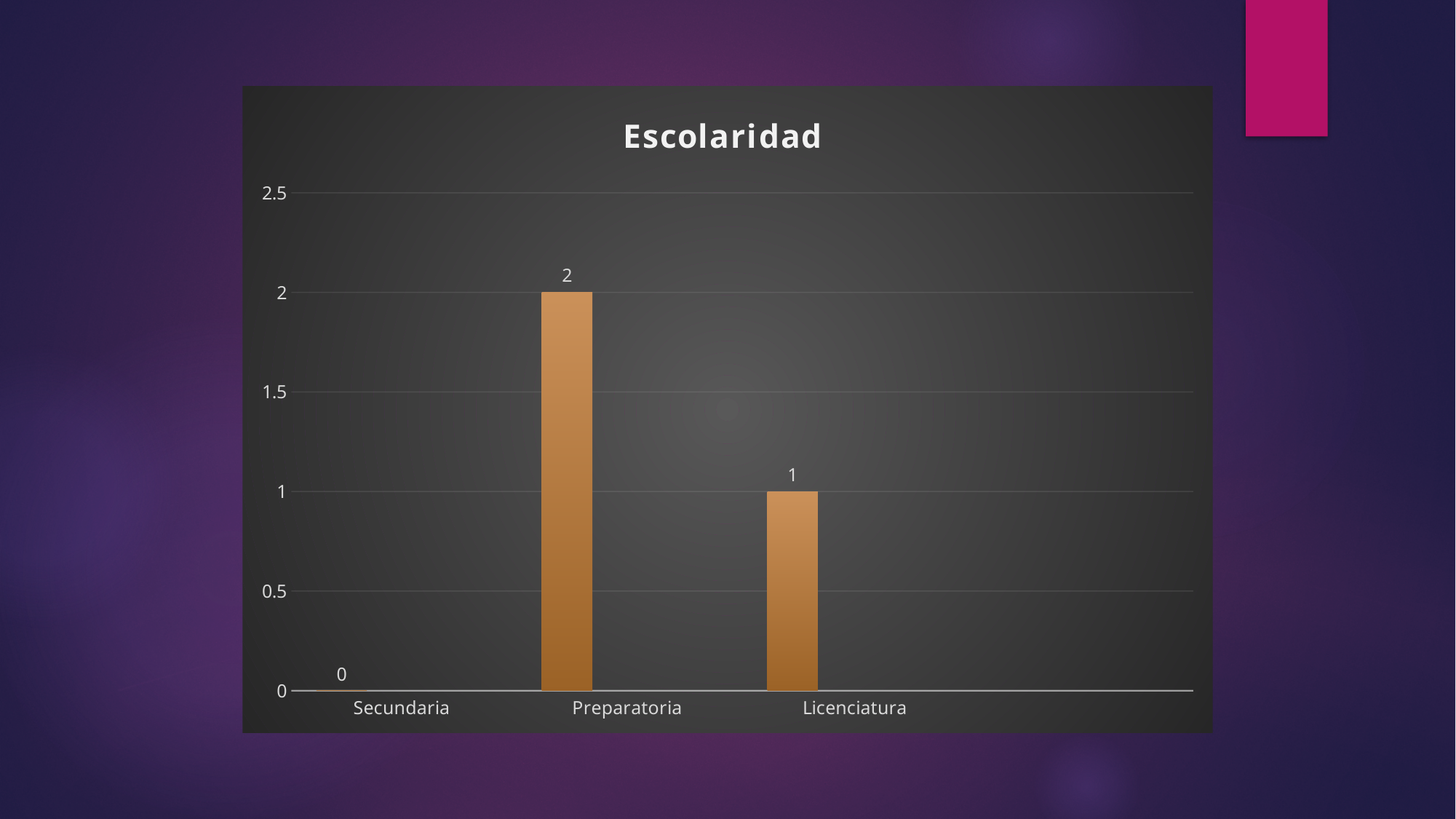
What is the value for Licenciatura? 1 Which category has the highest value? Preparatoria What kind of chart is shown on the slide? bar chart What is the difference between the values for Preparatoria and Licenciatura? 1 What is the highest value shown on the y axis? 2.5 Is the value for Preparatoria greater or less than 1.5? greater How many categories are shown on the x axis? 3 What is the value for Preparatoria? 2 What is the value for Secundaria? 0 Which category has the lowest value? Secundaria What is the title of the chart? Escolaridad Which is larger, the value for Licenciatura or the value for Secundaria? Licenciatura